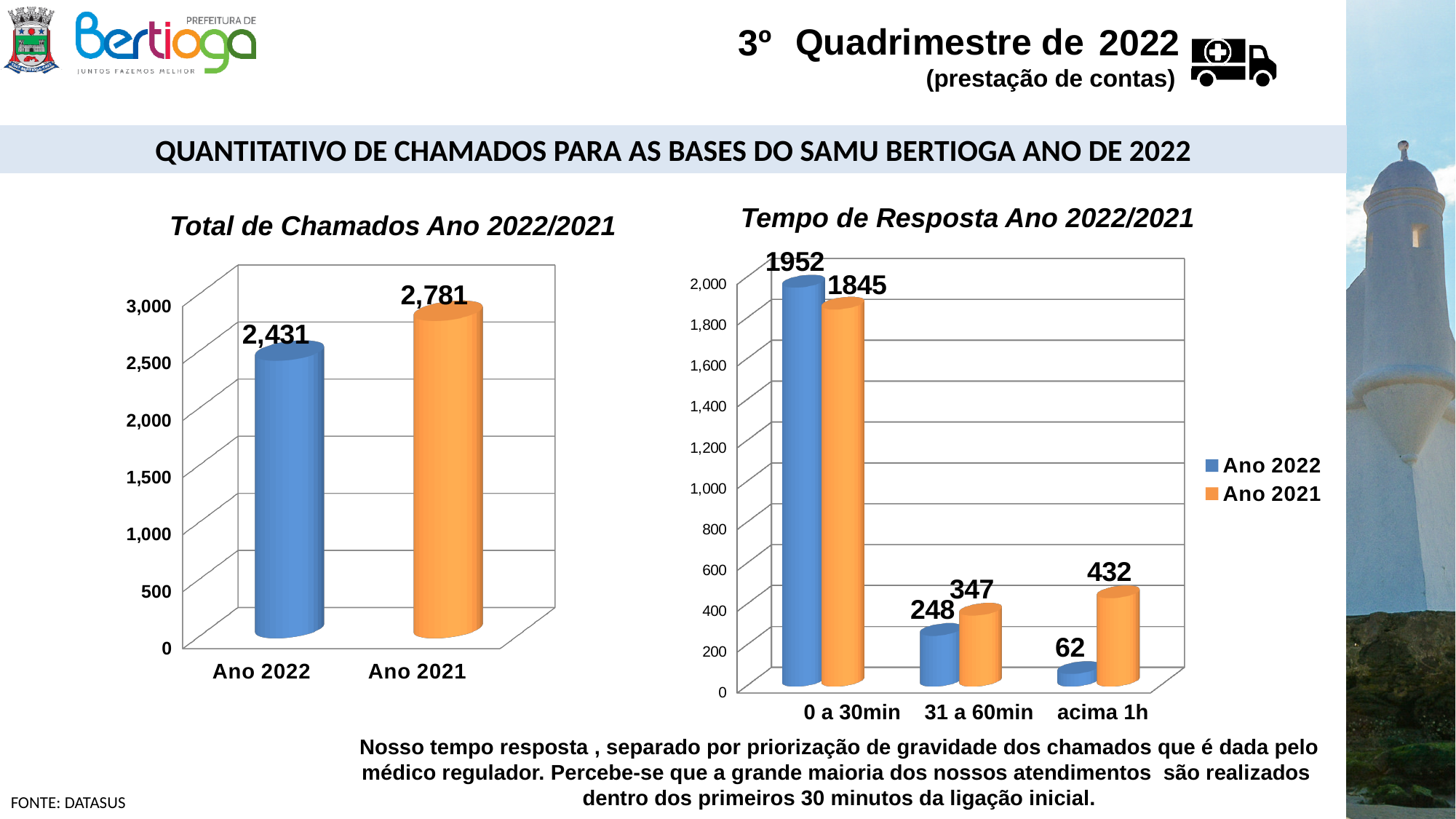
In the 'Total de Chamados Ano 2022/2021' chart, which year has the higher value? Ano 2021 In the 'Total de Chamados Ano 2022/2021' chart, what is the value for Ano 2021? 2,781 In the 'Tempo de Resposta Ano 2022/2021' chart, which category has the lowest Ano 2022 value? acima 1h What kind of chart is the 'Total de Chamados Ano 2022/2021' chart? Bar chart In the 'Total de Chamados Ano 2022/2021' chart, what is the value for Ano 2022? 2,431 In the 'Tempo de Resposta Ano 2022/2021' chart, how many series does the legend list? 2 In the 'Tempo de Resposta Ano 2022/2021' chart, how many categories are shown on the x axis? 3 In the 'Tempo de Resposta Ano 2022/2021' chart, what is the difference between the Ano 2021 and Ano 2022 values for '31 a 60min'? 99 In the 'Tempo de Resposta Ano 2022/2021' chart, what is the Ano 2022 value for '31 a 60min'? 248 In the 'Tempo de Resposta Ano 2022/2021' chart, what is the Ano 2022 value for '0 a 30min'? 1952 In the 'Total de Chamados Ano 2022/2021' chart, what is the difference between the Ano 2021 and Ano 2022 values? 350 In the 'Tempo de Resposta Ano 2022/2021' chart, what is the Ano 2021 value for 'acima 1h'? 432